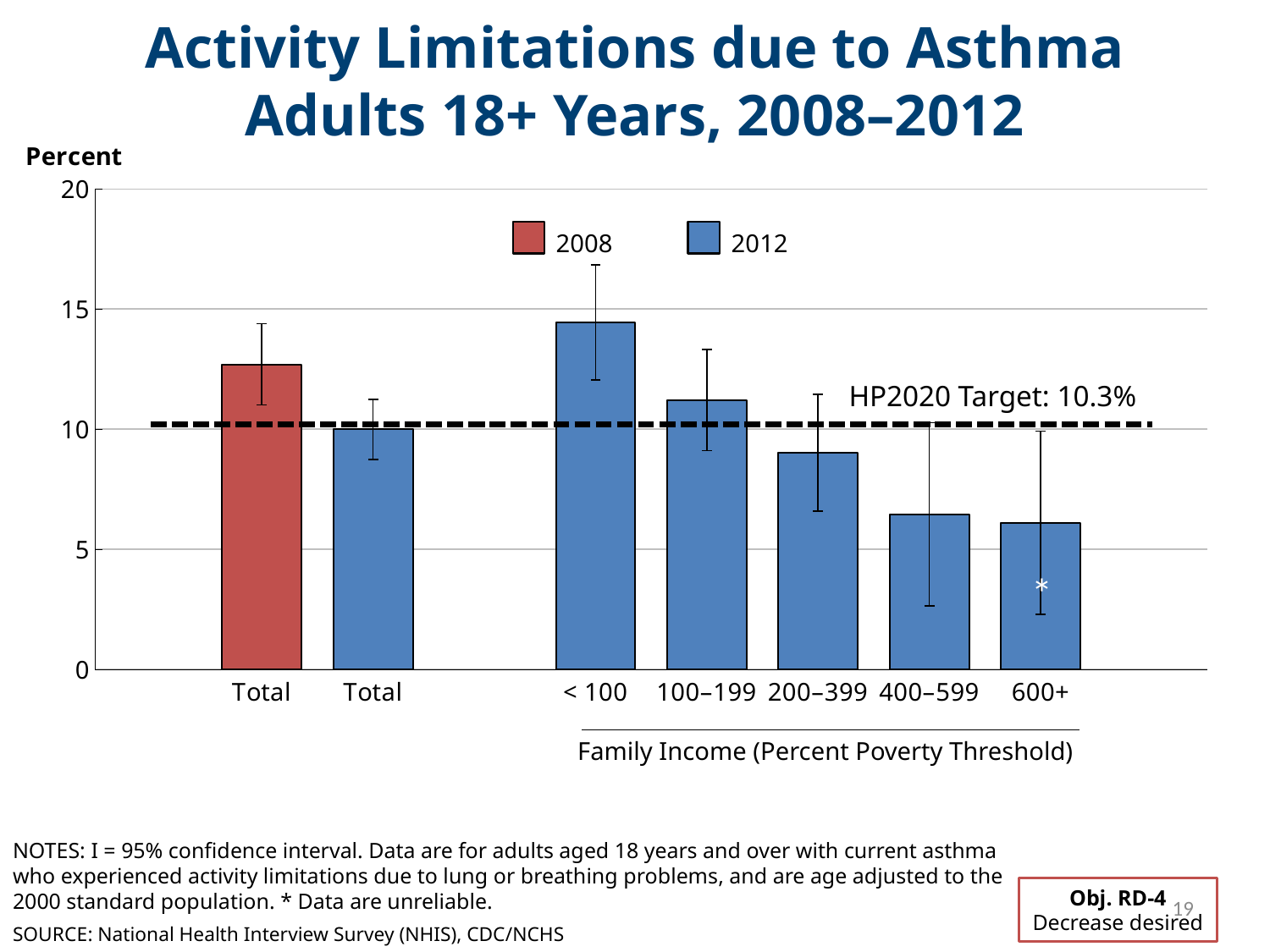
How many series does the legend list? 2 Is the value for the < 100 family income group greater or less than 10? greater Which category has the highest bar? < 100 Which family income category is marked with an asterisk indicating unreliable data? 600+ What is the HP2020 Target value shown on the chart? 10.3% Which is larger, the 2008 Total bar or the 2012 Total bar? 2008 Total Is the value for the 400–599 family income group greater or less than 10? less What kind of chart is shown on the slide? bar chart Is the value for the 2008 Total bar greater or less than 10? greater Which colour represents 2012 in the legend? blue How many bars are plotted in the chart? 7 Do the values rise or fall as family income increases from < 100 to 600+? fall